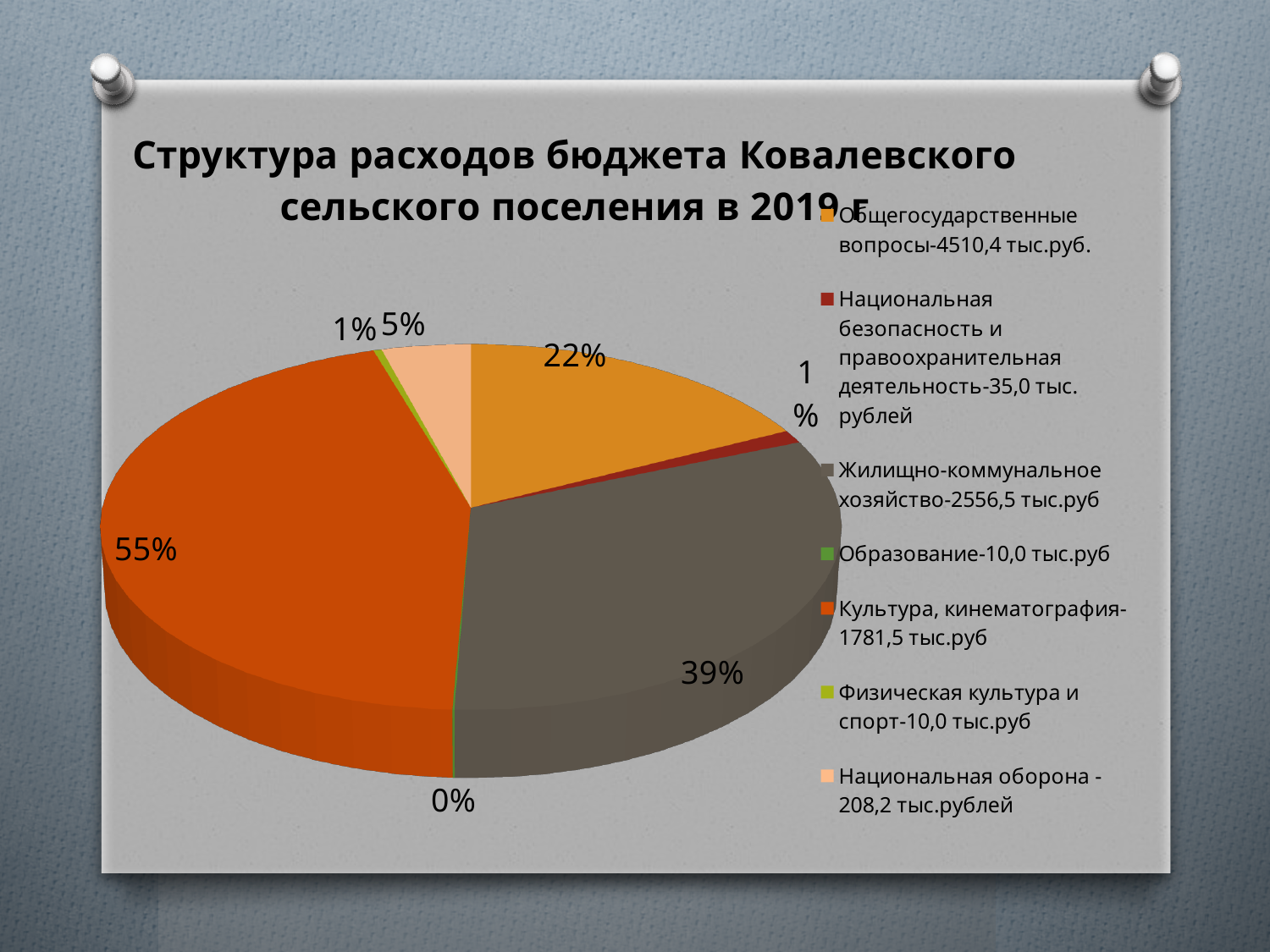
What kind of chart is shown on the slide? pie chart What percentage label is shown for the Национальная оборона slice? 5% What is the largest percentage label shown on the pie chart? 55% What is the difference in percentage points between the 55% slice and the 39% slice? 16 Which slice has the larger percentage label: Жилищно-коммунальное хозяйство or Общегосударственные вопросы? Жилищно-коммунальное хозяйство What percentage label is shown for the Культура, кинематография slice? 55% What amount does the legend give for Жилищно-коммунальное хозяйство? 2556,5 тыс.руб How many categories does the legend of the pie chart list? 7 What percentage label is shown for the Общегосударственные вопросы slice? 22% What percentage label is shown for the Образование slice? 0% What percentage label is shown for the Жилищно-коммунальное хозяйство slice? 39% What is the title of the chart? Структура расходов бюджета Ковалевского сельского поселения в 2019 г.